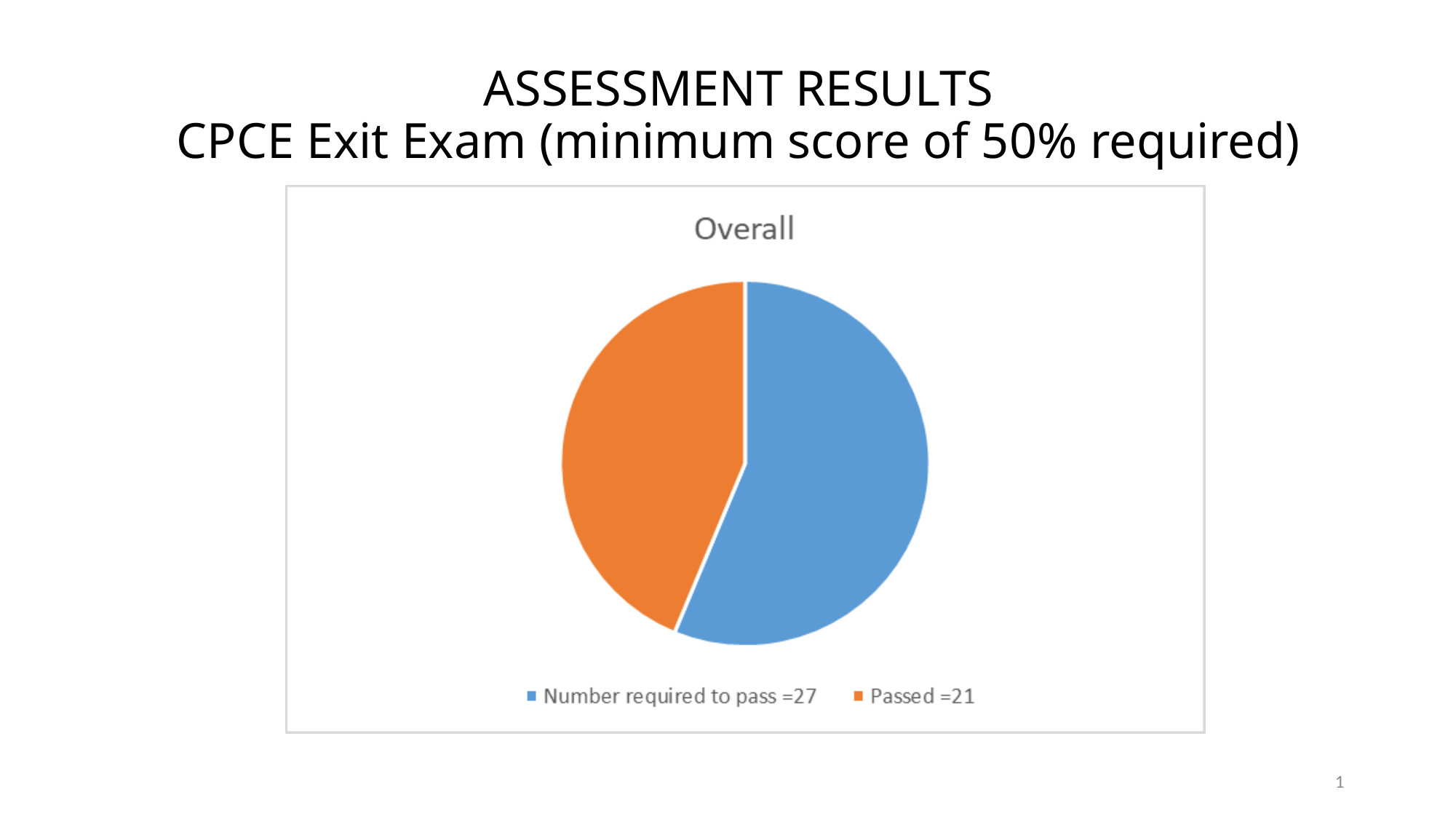
What is the chart's title? Overall What is the value for 'Passed'? 21 What is the value for 'Number required to pass'? 27 How many slices does the pie chart have? 2 Which slice is the smallest? Passed What colour is the 'Passed' slice? Orange What share of the pie does the 'Passed' slice represent? 43.75% What is the difference between 'Number required to pass' and 'Passed'? 6 Which slice is the largest? Number required to pass Which is larger, 'Number required to pass' or 'Passed'? Number required to pass How many entries does the legend list? 2 What kind of chart is shown on the slide? Pie chart